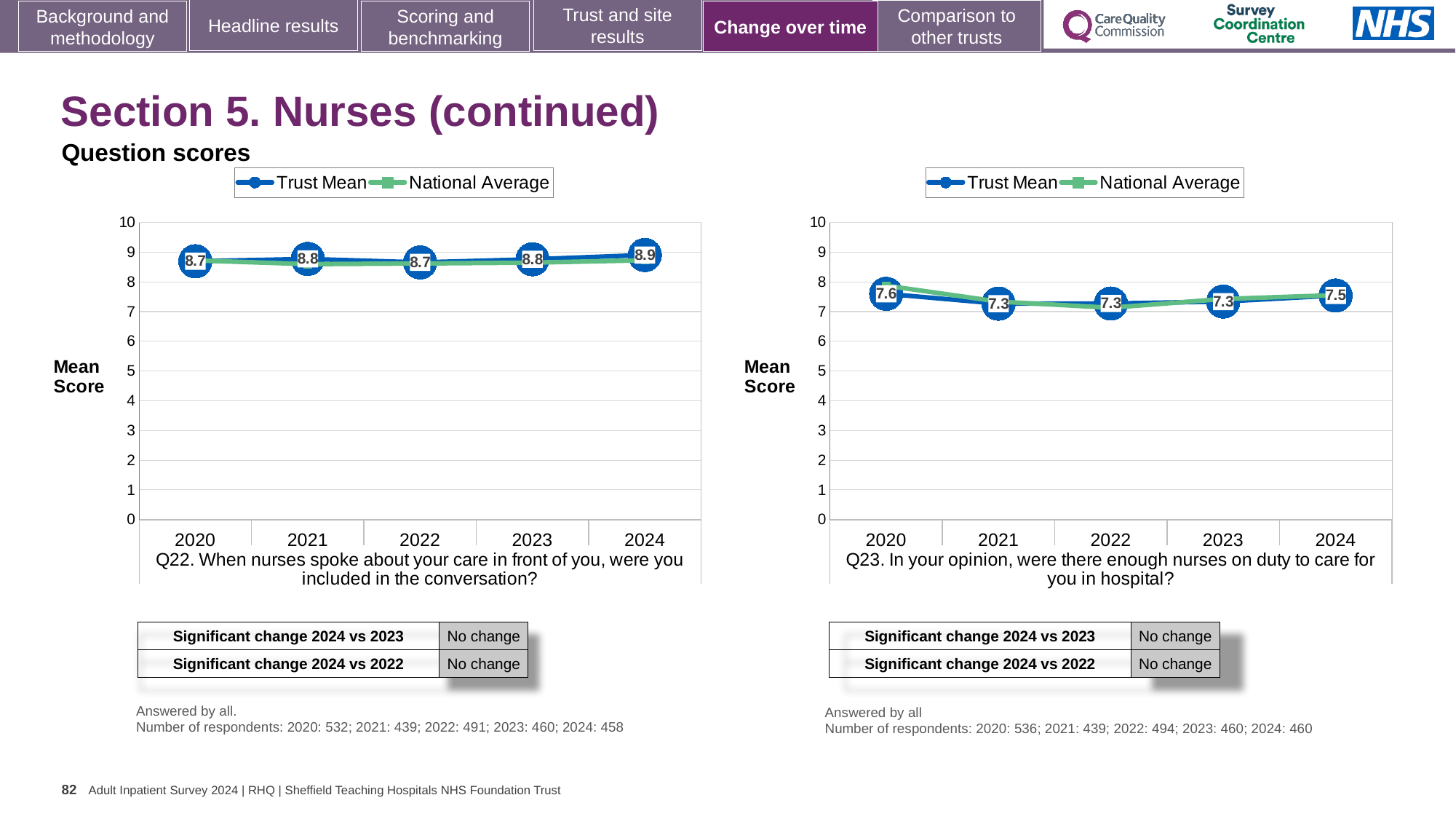
What kind of chart is the Q22 chart? Line chart How many years are plotted on the Q22 chart? 5 How many series does the legend of the Q23 chart list? 2 On the Q23 chart, which year has the highest Trust Mean score? 2020 On the Q22 chart, what is the Trust Mean score for 2020? 8.7 On the Q23 chart, what is the Trust Mean score for 2024? 7.5 On the Q23 chart, what is the Trust Mean score for 2020? 7.6 On the Q23 chart, what is the difference between the Trust Mean score in 2020 and in 2021? 0.3 On the Q22 chart, what is the difference between the Trust Mean score in 2024 and in 2023? 0.1 On the Q23 chart, is the Trust Mean score for 2021 greater or less than 8? less On the Q22 chart, which year has the highest Trust Mean score? 2024 On the Q22 chart, what is the Trust Mean score for 2024? 8.9